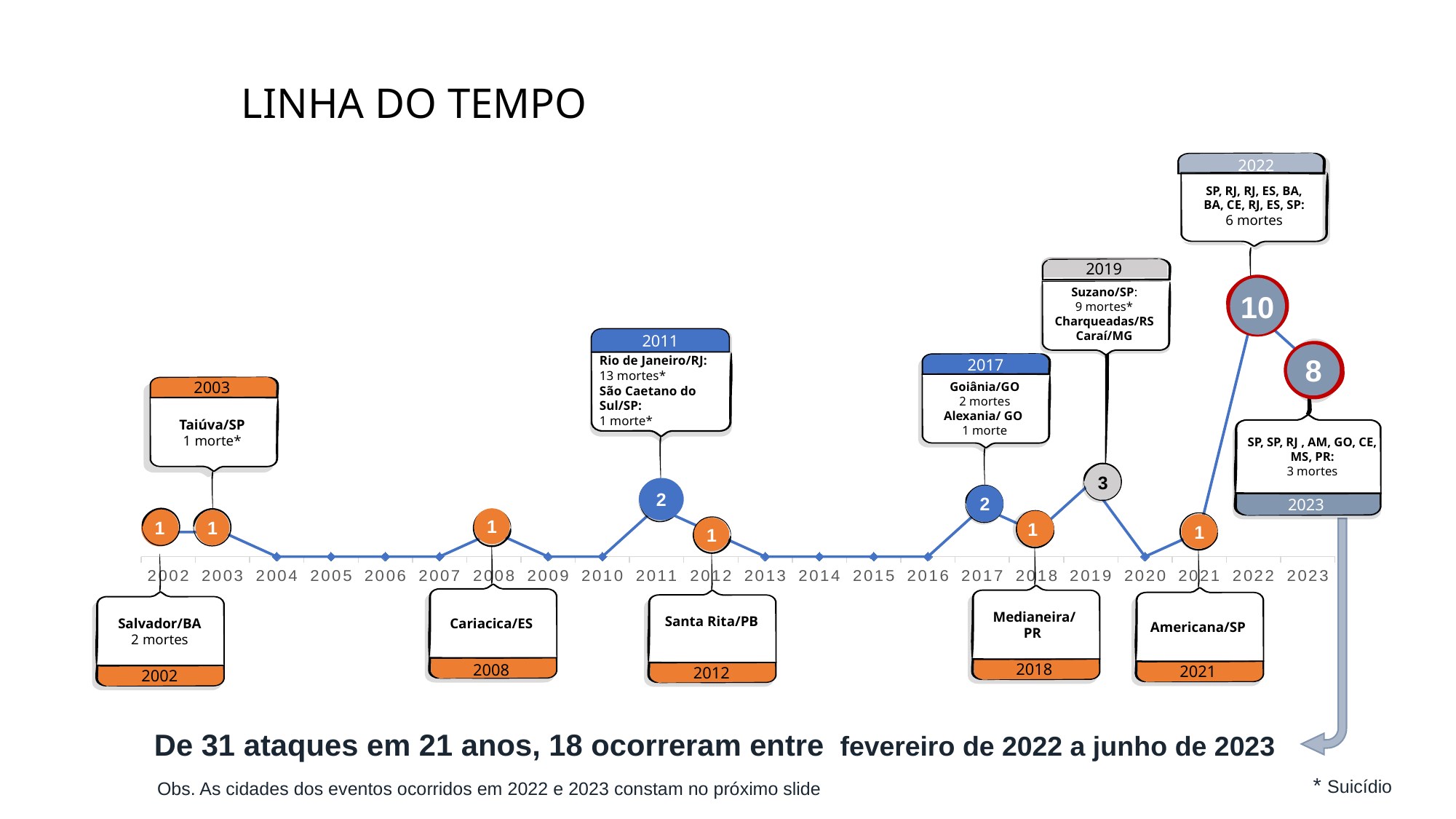
Do the values rise or fall from 2021 to 2022? rise What is the difference between the values for 2022 and 2023? 2 What is the value plotted for 2023? 8 What is the value plotted for 2011? 2 What kind of chart is shown on the slide? line chart What is the value plotted for 2022? 10 How many years are shown on the x axis of the timeline? 22 What is the title of the chart? LINHA DO TEMPO According to the callout for 2011, how many deaths occurred in Rio de Janeiro/RJ? 13 mortes* Which year has the highest value on the timeline? 2022 Which is larger, the value for 2019 or the value for 2017? 2019 What is the value plotted for 2019? 3